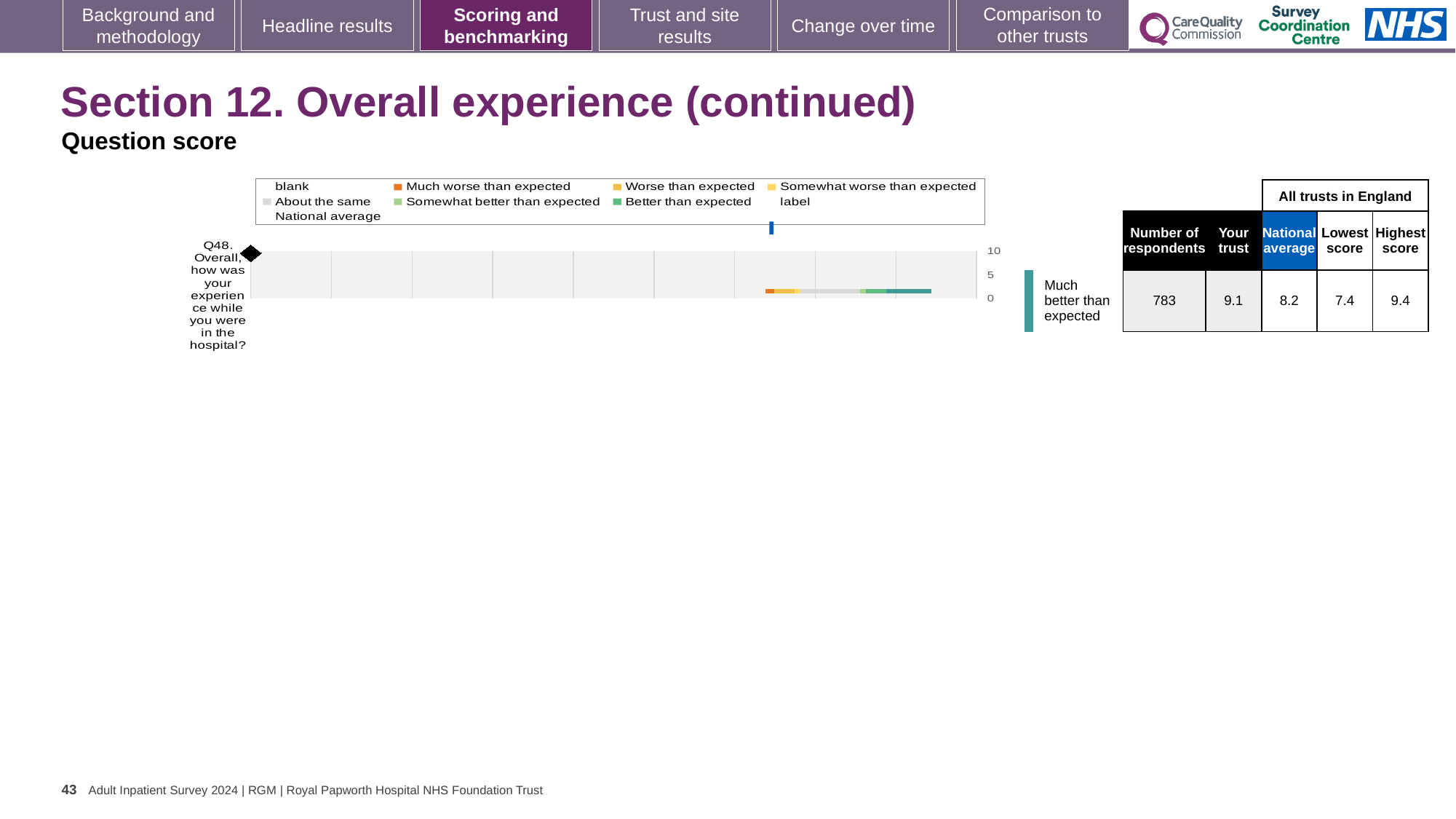
Which question is plotted in the chart? Q48. Overall, how was your experience while you were in the hospital? What is the highest score among all trusts in England for Q48? 9.4 What is the 'Your trust' score for Q48 shown next to the chart? 9.1 What benchmark category is assigned to the trust for Q48? Much better than expected What is the highest tick value shown on the chart's score axis? 10 By how much does the 'Your trust' score for Q48 exceed the national average? 0.9 What is the lowest score among all trusts in England for Q48? 7.4 How many questions (categories) are plotted in the chart? 1 What kind of chart is shown for Q48 on the slide? bar chart Which is larger for Q48: the 'Your trust' score or the national average? Your trust What is the national average score for Q48 shown next to the chart? 8.2 How many respondents answered Q48? 783